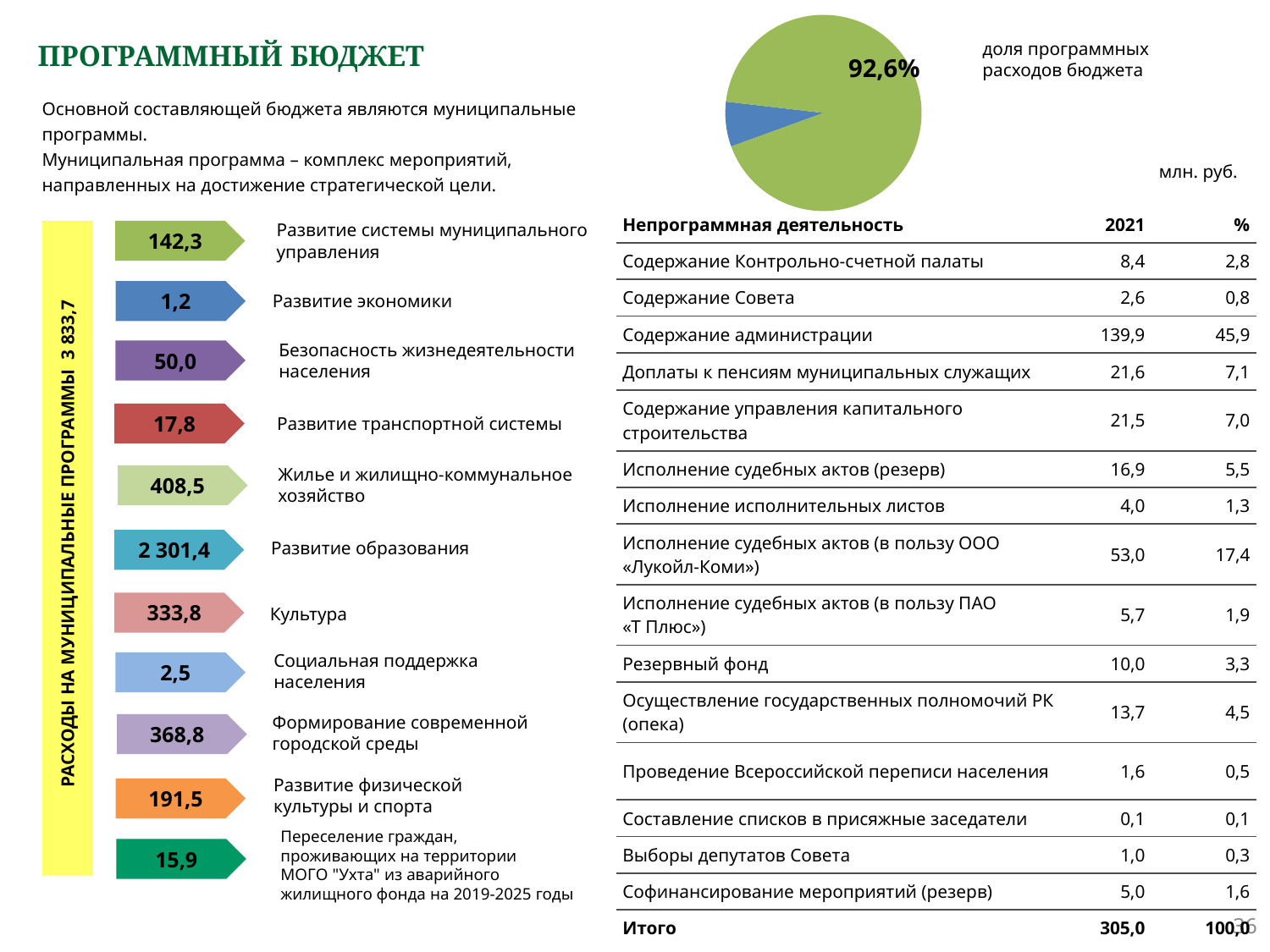
In the pie chart at the top right, is the share of the green slice greater or less than 50%? greater In the diagram of municipal programs on the left, which program has the lowest value? Развитие экономики In the pie chart at the top right, what share is shown for the green slice (доля программных расходов бюджета)? 92,6% In the diagram of municipal programs on the left, what is the value for Развитие образования? 2 301,4 In the diagram of municipal programs on the left, what is the difference between Жилье и жилищно-коммунальное хозяйство (408,5) and Формирование современной городской среды (368,8)? 39,7 What does the text next to the pie chart say the 92,6% represents? доля программных расходов бюджета In the diagram of municipal programs on the left, how many programs are listed? 11 In the pie chart at the top right, which slice is larger, the green one or the blue one? the green one What kind of chart is shown at the top right of the slide? pie chart In the diagram of municipal programs on the left, what total is shown on the yellow bar for РАСХОДЫ НА МУНИЦИПАЛЬНЫЕ ПРОГРАММЫ? 3 833,7 In the diagram of municipal programs on the left, which program has the highest value? Развитие образования How many slices does the pie chart at the top right have? 2